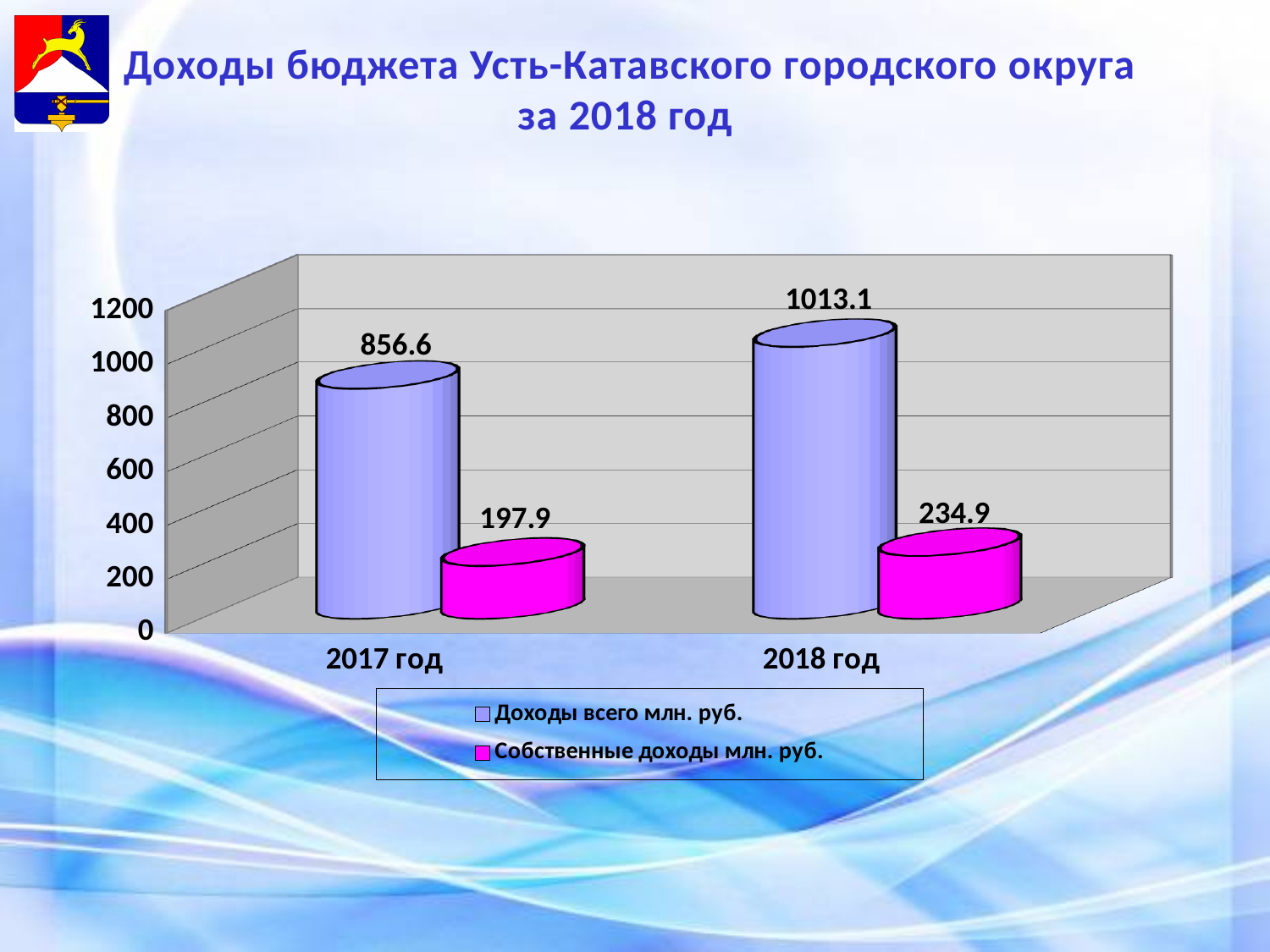
What is the difference between "Собственные доходы млн. руб." in 2018 год and 2017 год? 37.0 How many series does the legend list? 2 What is the difference between "Доходы всего млн. руб." in 2018 год and 2017 год? 156.5 Does "Доходы всего млн. руб." rise or fall from 2017 год to 2018 год? rise What kind of chart is shown on the slide? bar chart What is the value of "Собственные доходы млн. руб." for 2017 год? 197.9 How many categories are shown on the x axis? 2 What is the value of "Доходы всего млн. руб." for 2017 год? 856.6 What is the value of "Собственные доходы млн. руб." for 2018 год? 234.9 Which year has the lower value for "Собственные доходы млн. руб."? 2017 год Is "Собственные доходы млн. руб." for 2018 год larger or smaller than "Собственные доходы млн. руб." for 2017 год? larger Which year has the higher value for "Доходы всего млн. руб."? 2018 год